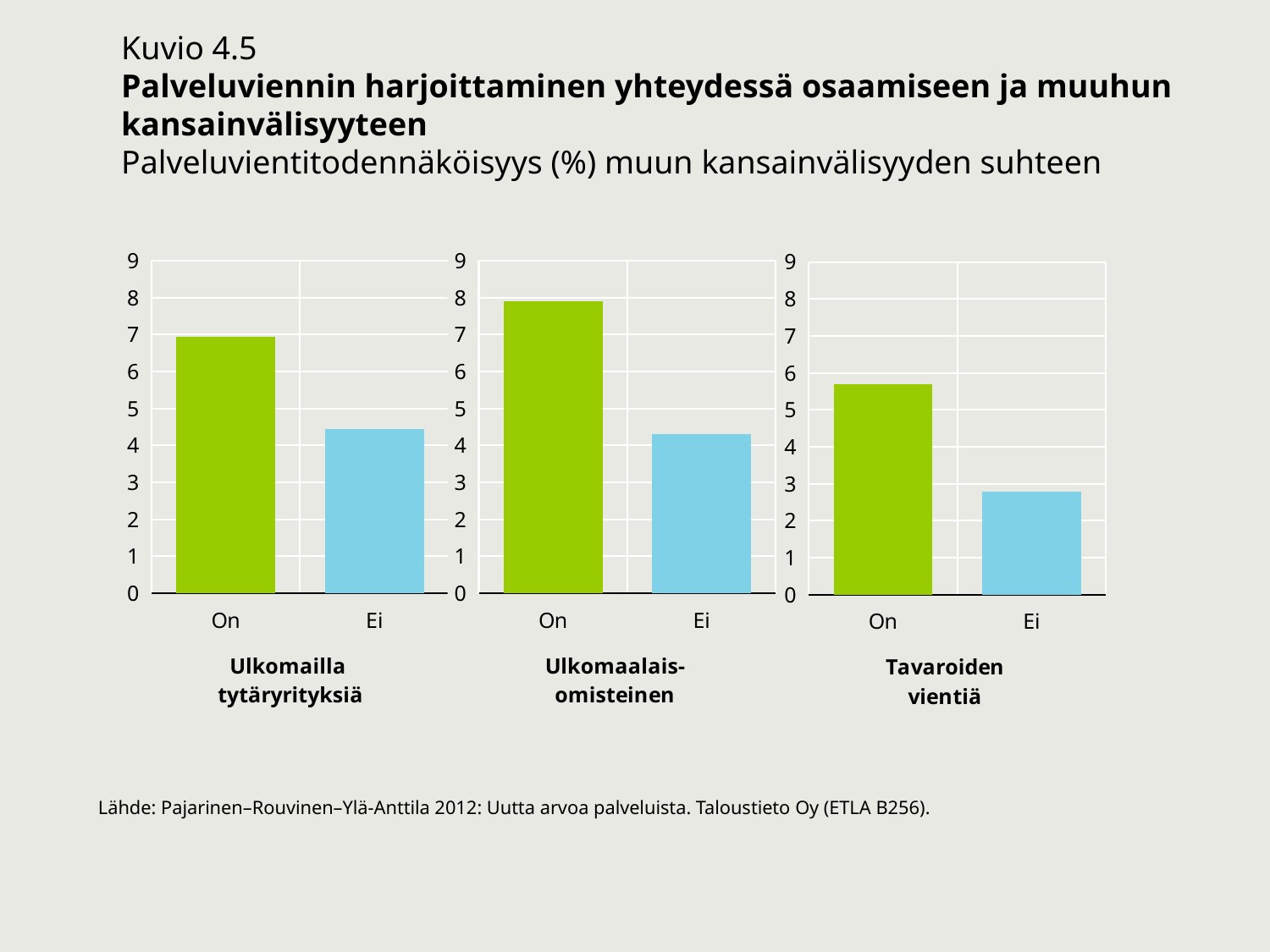
In the 'Ulkomaalaisomisteinen' chart, which category has the highest value? On In the 'Ulkomailla tytäryrityksiä' chart, is the value for Ei greater or less than 5? less In the 'Ulkomaalaisomisteinen' chart, is the value for On greater or less than 7? greater In the 'Tavaroiden vientiä' chart, which category has the lowest value? Ei In the 'Tavaroiden vientiä' chart, is the value for Ei greater or less than 3? less What kind of chart is the 'Ulkomailla tytäryrityksiä' chart? bar chart How many separate charts are shown on the slide? 3 In the 'Ulkomailla tytäryrityksiä' chart, which category has the higher value, On or Ei? On How many bars are shown in the 'Tavaroiden vientiä' chart? 2